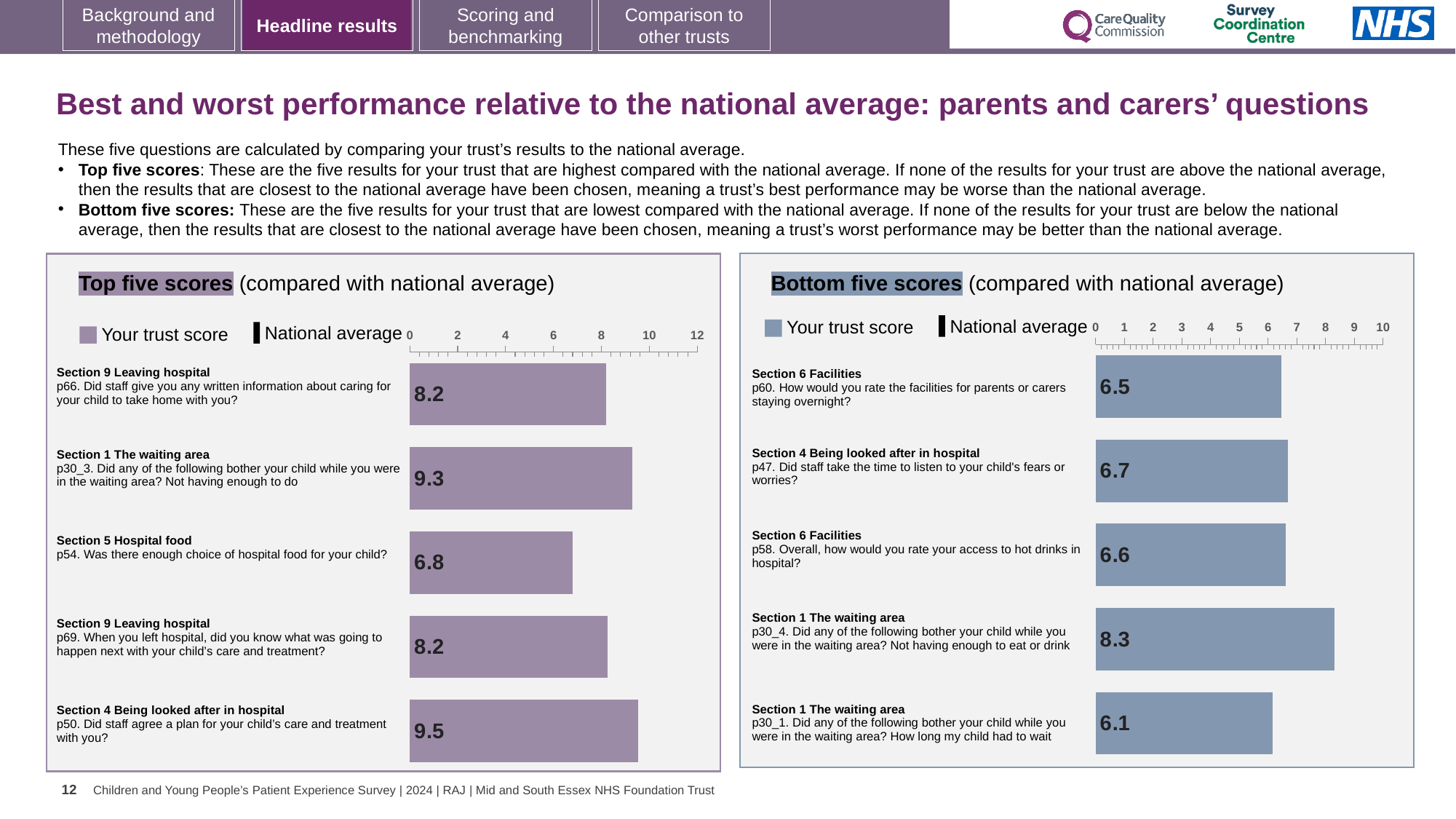
In the Bottom five scores chart, what is the trust score for p60 (How would you rate the facilities for parents or carers staying overnight?)? 6.5 In the Bottom five scores chart, which question has the lowest trust score? p30_1. Did any of the following bother your child while you were in the waiting area? How long my child had to wait In the Top five scores chart, which question has the highest trust score? p50. Did staff agree a plan for your child's care and treatment with you? In the Top five scores chart, what is the trust score for p54 (Was there enough choice of hospital food for your child?)? 6.8 What kind of chart is the Bottom five scores chart? Bar chart In the Bottom five scores chart, which has the larger trust score: p47 or p58? p47 In the Top five scores chart, what is the trust score for p50 (Did staff agree a plan for your child's care and treatment with you?)? 9.5 In the Top five scores chart, what colour are the bars for Your trust score? Purple How many questions are plotted in the Top five scores chart? 5 In the Top five scores chart, what is the difference between the trust scores for p30_3 and p54? 2.5 In the Bottom five scores chart, what is the difference between the trust scores for p30_4 and p30_1? 2.2 In the Bottom five scores chart, what is the trust score for p30_4 (Not having enough to eat or drink in the waiting area)? 8.3